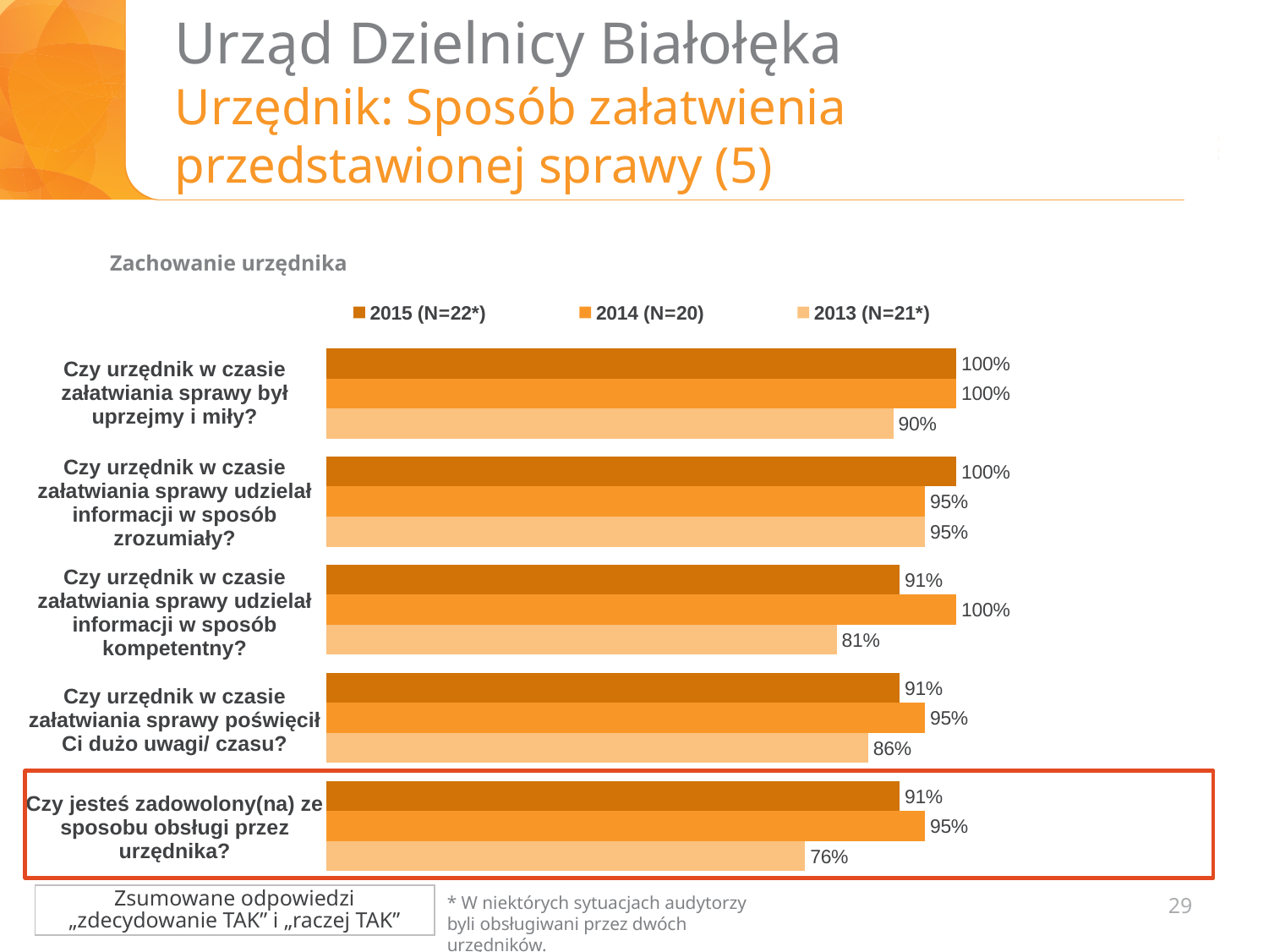
What is the 2015 (N=22*) value for "Czy urzędnik w czasie załatwiania sprawy udzielał informacji w sposób kompetentny?"? 91% What is the 2013 (N=21*) value for "Czy jesteś zadowolony(na) ze sposobu obsługi przez urzędnika?"? 76% What kind of chart is shown on the slide? bar chart Which category has the lowest 2013 (N=21*) value? Czy jesteś zadowolony(na) ze sposobu obsługi przez urzędnika? How many question categories are plotted in the chart? 5 What is the difference between the 2015 (N=22*) and 2013 (N=21*) values for "Czy jesteś zadowolony(na) ze sposobu obsługi przez urzędnika?"? 15 percentage points What is the difference between the 2014 (N=20) and 2013 (N=21*) values for "Czy urzędnik w czasie załatwiania sprawy udzielał informacji w sposób kompetentny?"? 19 percentage points What is the title shown above the chart? Zachowanie urzędnika For "Czy urzędnik w czasie załatwiania sprawy udzielał informacji w sposób kompetentny?", which is larger: the 2015 (N=22*) value or the 2014 (N=20) value? 2014 (N=20) What is the 2013 (N=21*) value for "Czy urzędnik w czasie załatwiania sprawy był uprzejmy i miły?"? 90% How many series does the legend list? 3 What is the 2014 (N=20) value for "Czy urzędnik w czasie załatwiania sprawy poświęcił Ci dużo uwagi/ czasu?"? 95%